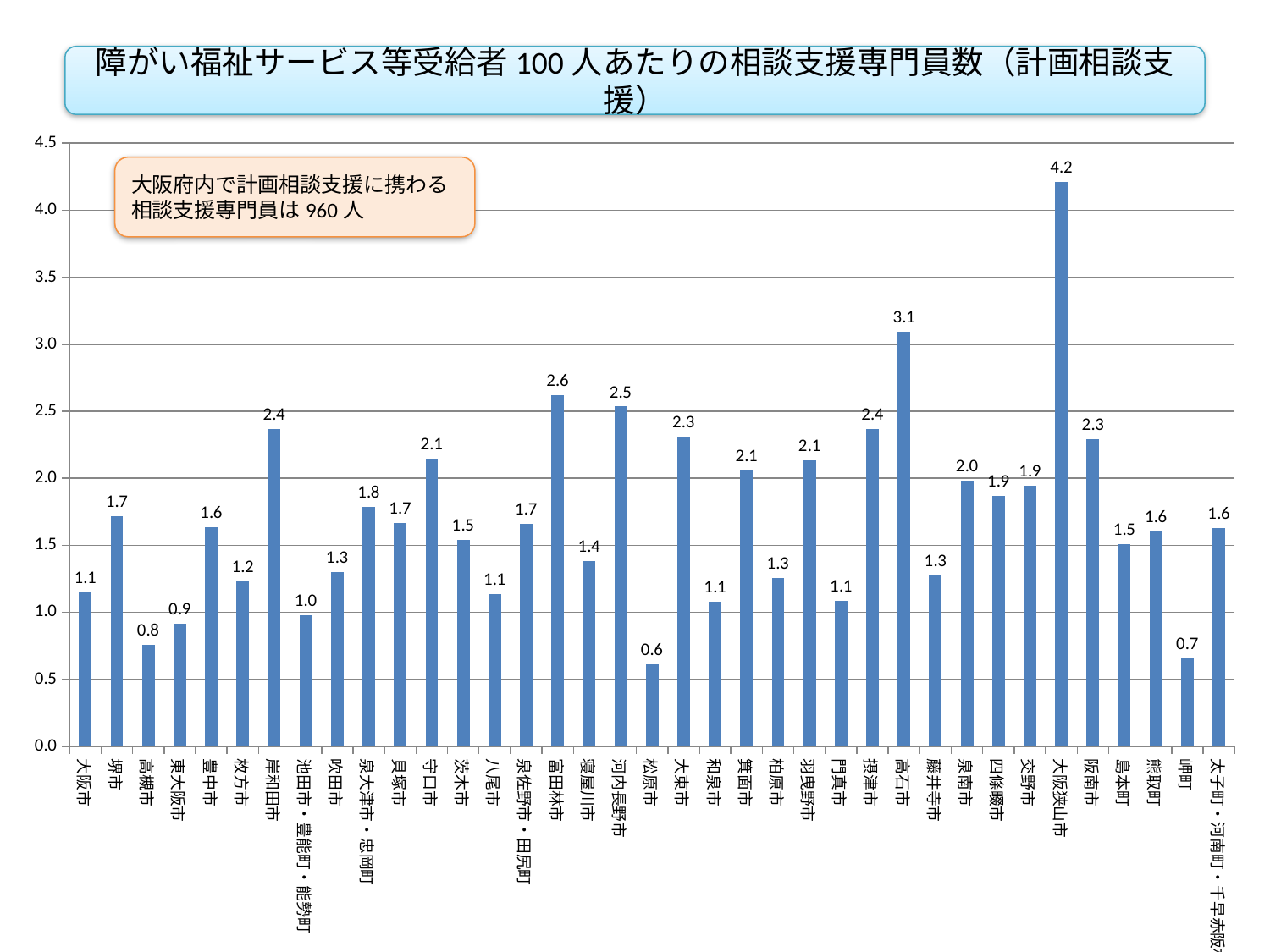
What is the difference between the values for 大阪狭山市 and 高石市? 1.1 Which category has the highest value? 大阪狭山市 Is the value for 岸和田市 greater or less than 2.0? greater According to the text box on the chart, how many 相談支援専門員 are engaged in 計画相談支援 in 大阪府? 960人 What is the value for 大阪狭山市? 4.2 Which category has the lowest value? 松原市 Which is larger, the value for 富田林市 or the value for 河内長野市? 富田林市 What kind of chart is shown on the slide? bar chart How many categories are shown on the x axis? 37 What is the value for 大阪市? 1.1 What is the value for 松原市? 0.6 What is the value for 高石市? 3.1